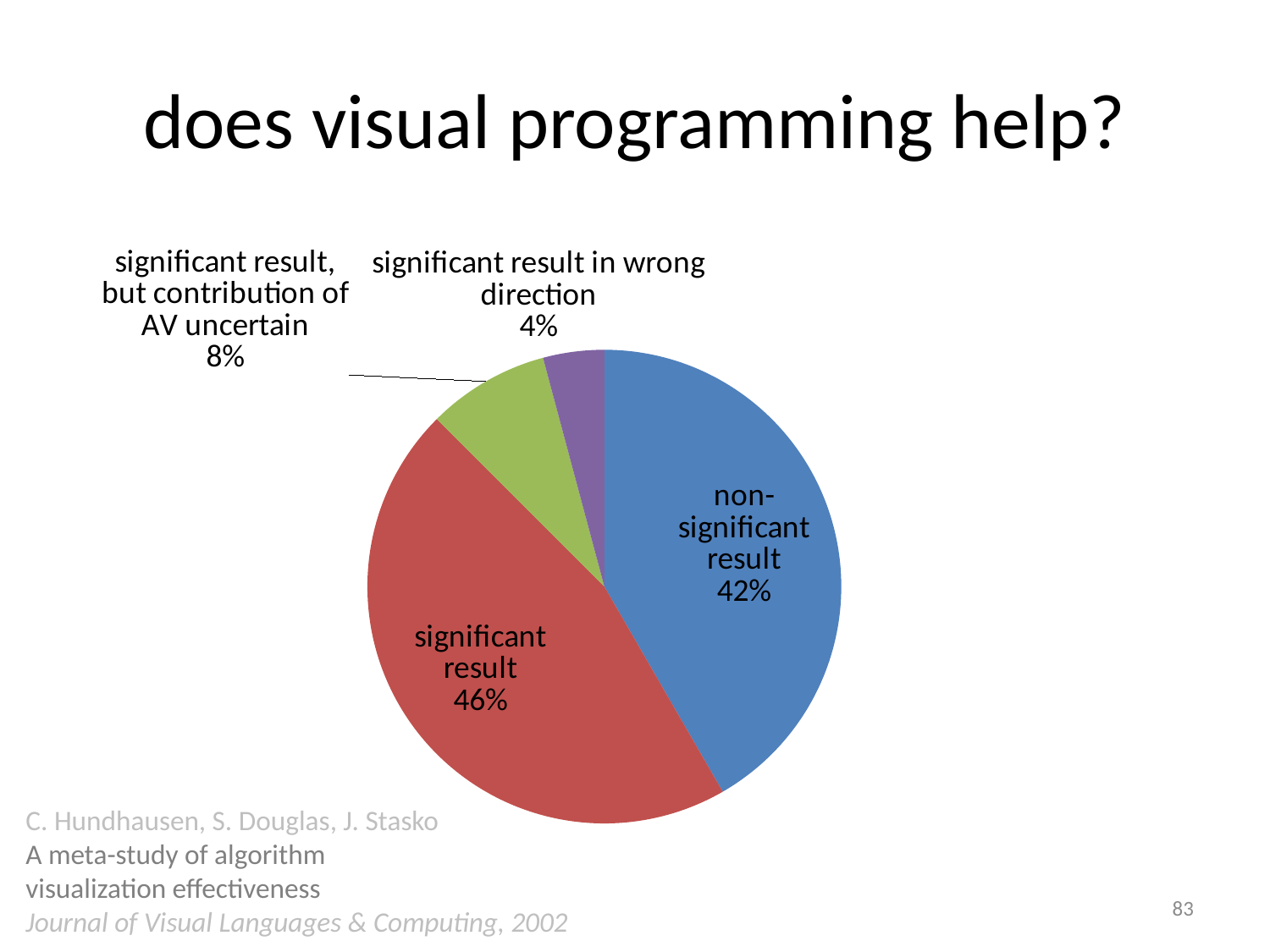
Which slice of the pie is the smallest? significant result in wrong direction What share of the pie is labelled "significant result, but contribution of AV uncertain"? 8% How many slices does the pie chart have? 4 What is the difference in percentage points between the "significant result" slice and the "non-significant result" slice? 4 What is the combined share of the "significant result, but contribution of AV uncertain" and "significant result in wrong direction" slices? 12% What share of the pie is labelled "significant result in wrong direction"? 4% Which is larger: the "significant result, but contribution of AV uncertain" slice or the "significant result in wrong direction" slice? significant result, but contribution of AV uncertain What kind of chart is shown on the slide? pie chart What share of the pie is labelled "non-significant result"? 42% What colour is the "non-significant result" slice? blue Which slice of the pie is the largest? significant result